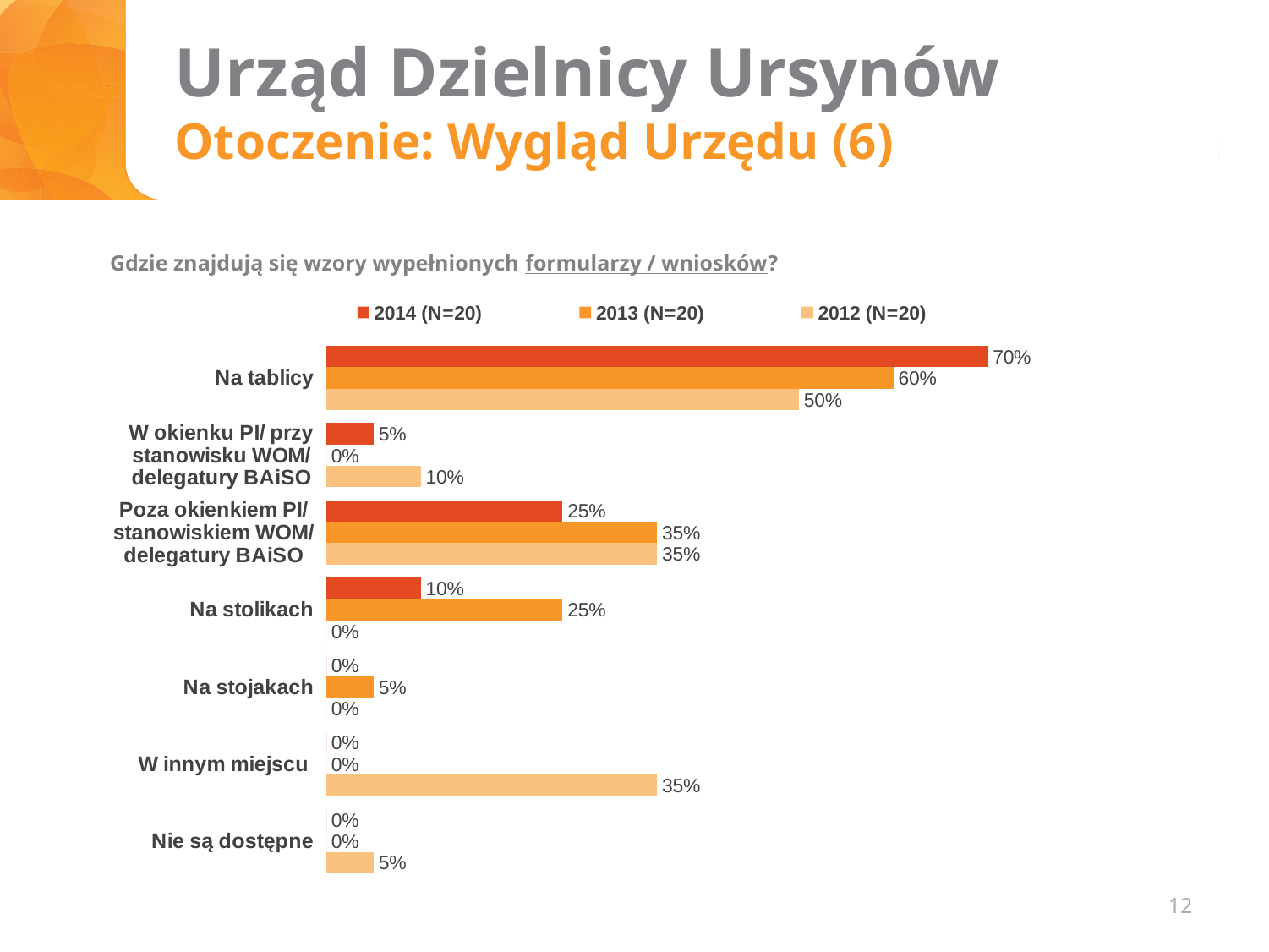
How many series does the legend list? 3 What is the value for 'Na tablicy' in the 2014 (N=20) series? 70% Which category has the highest value in the 2014 (N=20) series? Na tablicy What question is the chart about, as stated above it? Gdzie znajdują się wzory wypełnionych formularzy / wniosków? How many categories are shown on the chart? 7 Which is larger for 'Na stolikach': the 2014 (N=20) value or the 2013 (N=20) value? 2013 (N=20) What is the difference between the 2014 (N=20) and 2012 (N=20) values for 'Na tablicy'? 20% What is the value for 'Nie są dostępne' in the 2012 (N=20) series? 5% What kind of chart is shown on the slide? bar chart What is the value for 'W innym miejscu' in the 2012 (N=20) series? 35% What is the value for 'Na stolikach' in the 2013 (N=20) series? 25% How did the value for 'Na tablicy' change from 2012 (N=20) to 2014 (N=20)? It rose